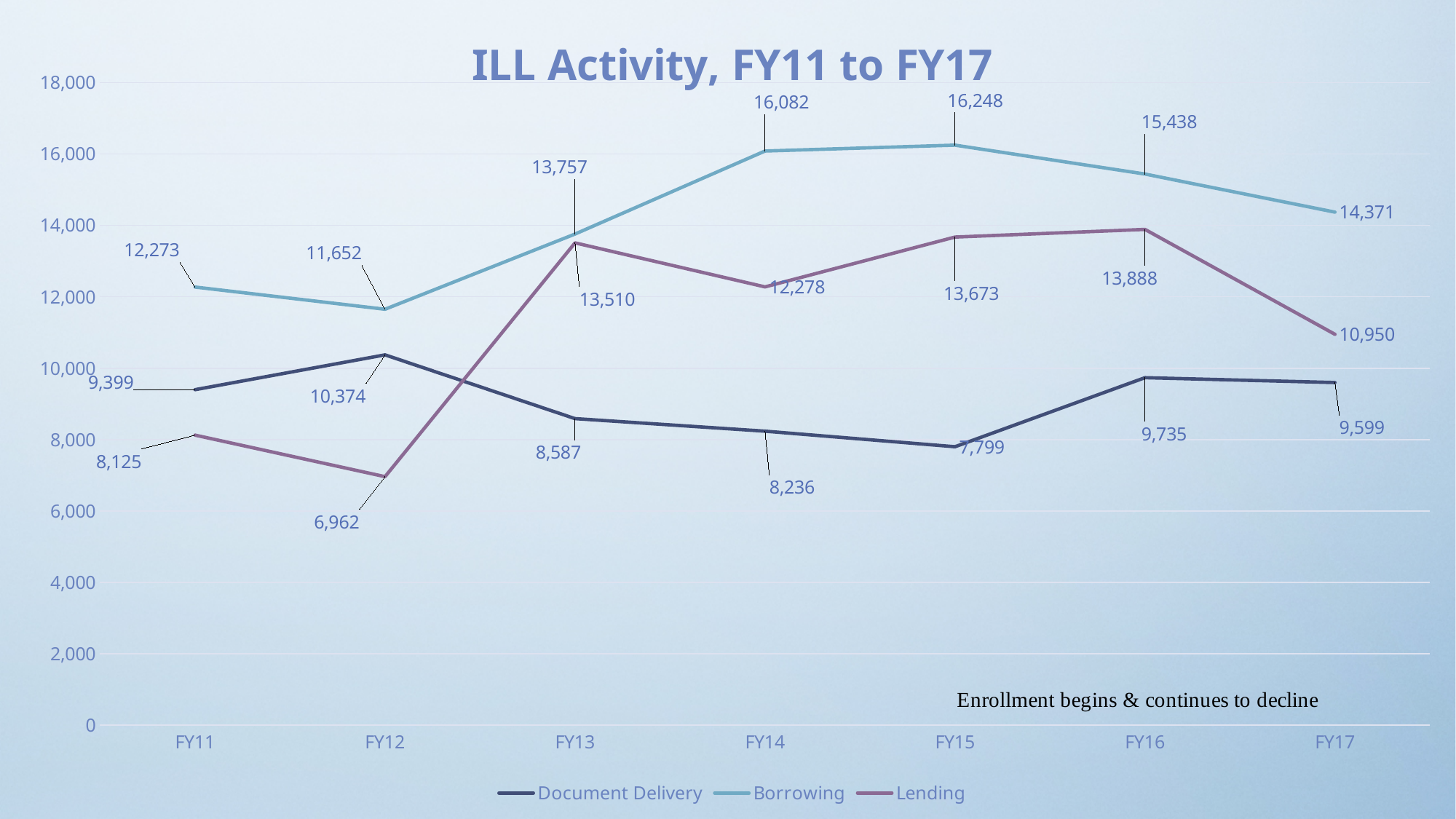
How many series does the legend list? 3 Does Lending rise or fall from FY16 to FY17? Fall Which is larger in FY12, Document Delivery or Lending? Document Delivery In which fiscal year is Document Delivery lowest? FY15 What is the Borrowing value for FY15? 16,248 What type of chart is shown on the slide? Line chart What is the Document Delivery value for FY16? 9,735 In which fiscal year is Borrowing highest? FY15 What is the Lending value for FY12? 6,962 What is the title of the chart? ILL Activity, FY11 to FY17 How many fiscal years are plotted on the x axis? 7 What is the difference between Borrowing and Lending in FY17? 3,421